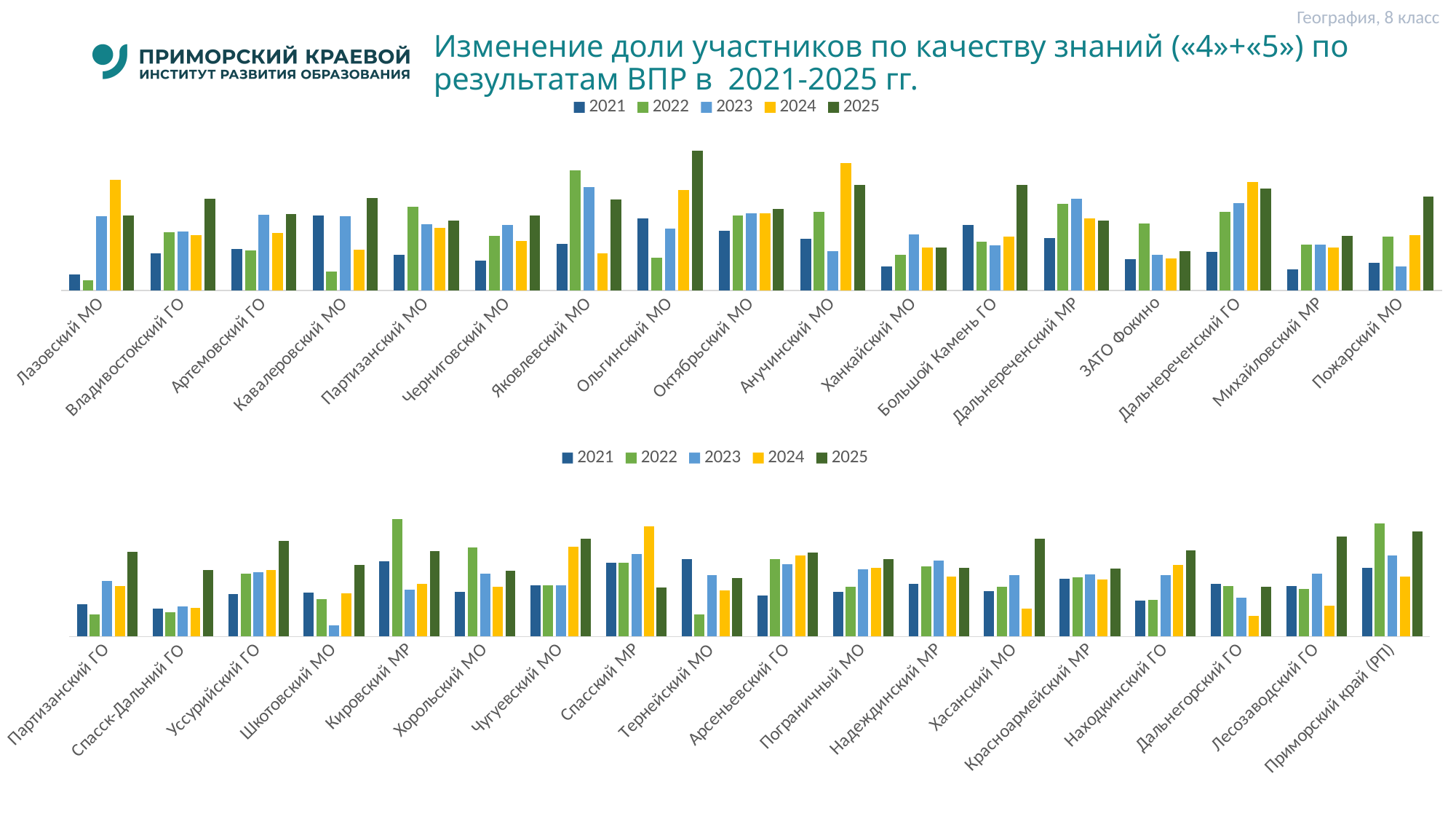
In the top chart, which year has the highest bar for Ольгинский МО? 2025 How many categories are shown on the x axis of the bottom chart? 18 In the bottom chart, which year has the highest bar for Кировский МР? 2022 Which years are listed in the legend of the bottom chart? 2021, 2022, 2023, 2024, 2025 In the bottom chart, which year has the lowest bar for Шкотовский МО? 2023 In the top chart, which year has the lowest bar for Лазовский МО? 2022 In the top chart, which year has the highest bar for Яковлевский МО? 2022 In the bottom chart, which is larger for Тернейский МО: the 2021 bar or the 2022 bar? 2021 How many series does the legend of the top chart list? 5 How many categories (municipalities) are shown on the x axis of the top chart? 17 What kind of chart is the top chart on the slide? bar chart